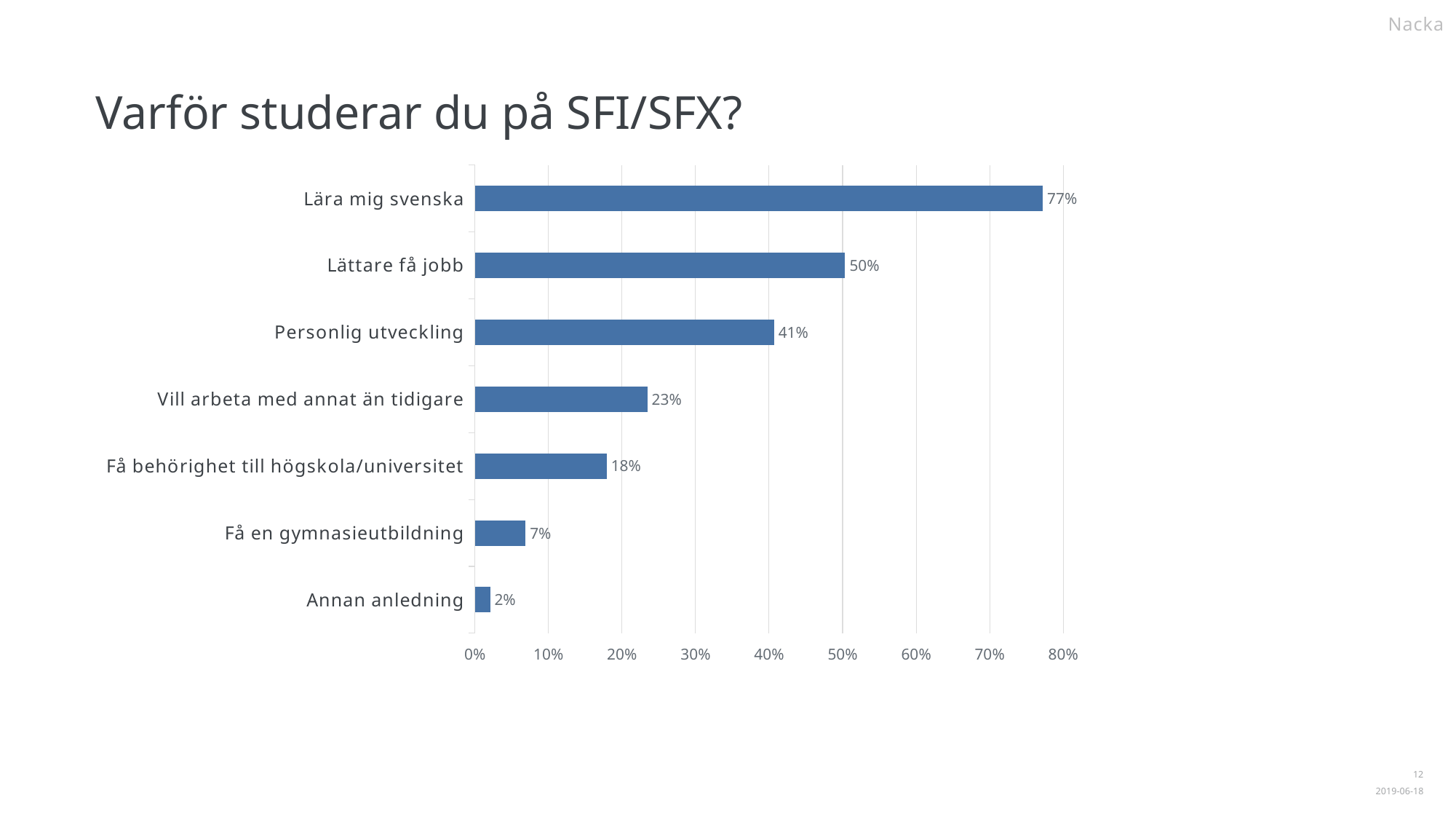
What is the difference between the values for "Lättare få jobb" and "Vill arbeta med annat än tidigare"? 27% What is the value for "Personlig utveckling"? 41% What is the highest value shown on the x axis? 80% How many categories are shown in the chart? 7 What is the title of the slide? Varför studerar du på SFI/SFX? What is the value for "Få behörighet till högskola/universitet"? 18% Which is larger, the value for "Få en gymnasieutbildning" or the value for "Få behörighet till högskola/universitet"? Få behörighet till högskola/universitet Is the value for "Lättare få jobb" greater or less than 40%? greater Which category has the highest value? Lära mig svenska Which category has the lowest value? Annan anledning What is the value for "Lära mig svenska"? 77% What kind of chart is shown on the slide? Bar chart